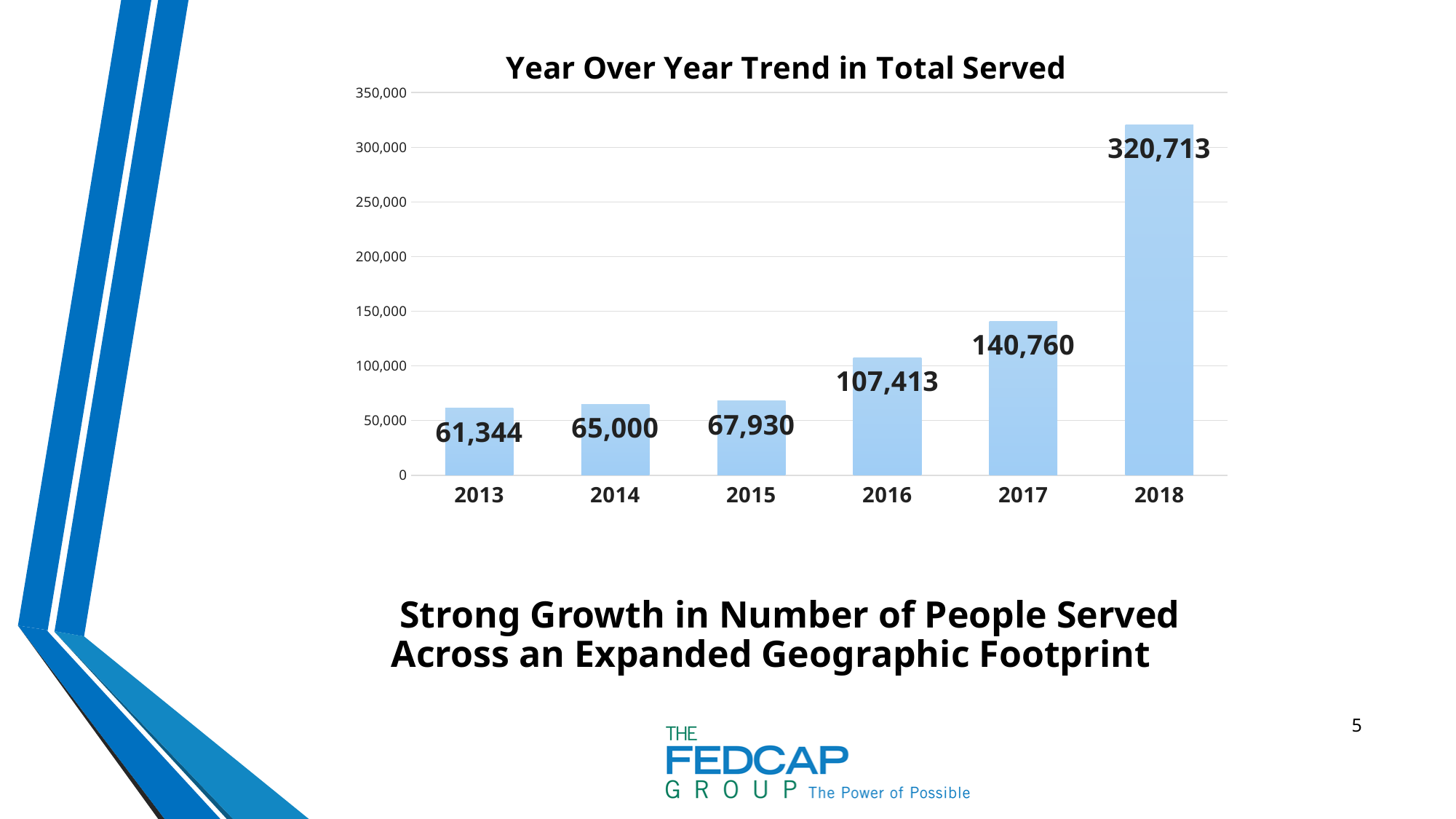
What kind of chart is shown on the slide? Bar chart What is the total served in 2016? 107,413 Is the value for 2018 greater or less than 300,000? greater How many years are shown on the x axis? 6 Which year has the highest total served? 2018 Do the values rise or fall from 2013 to 2018? Rise Which year has the lowest total served? 2013 What is the difference between the total served in 2015 and 2014? 2,930 What is the title of the chart? Year Over Year Trend in Total Served Which year had a larger total served, 2016 or 2017? 2017 What is the difference between the total served in 2018 and 2017? 179,953 What value is shown for 2013? 61,344